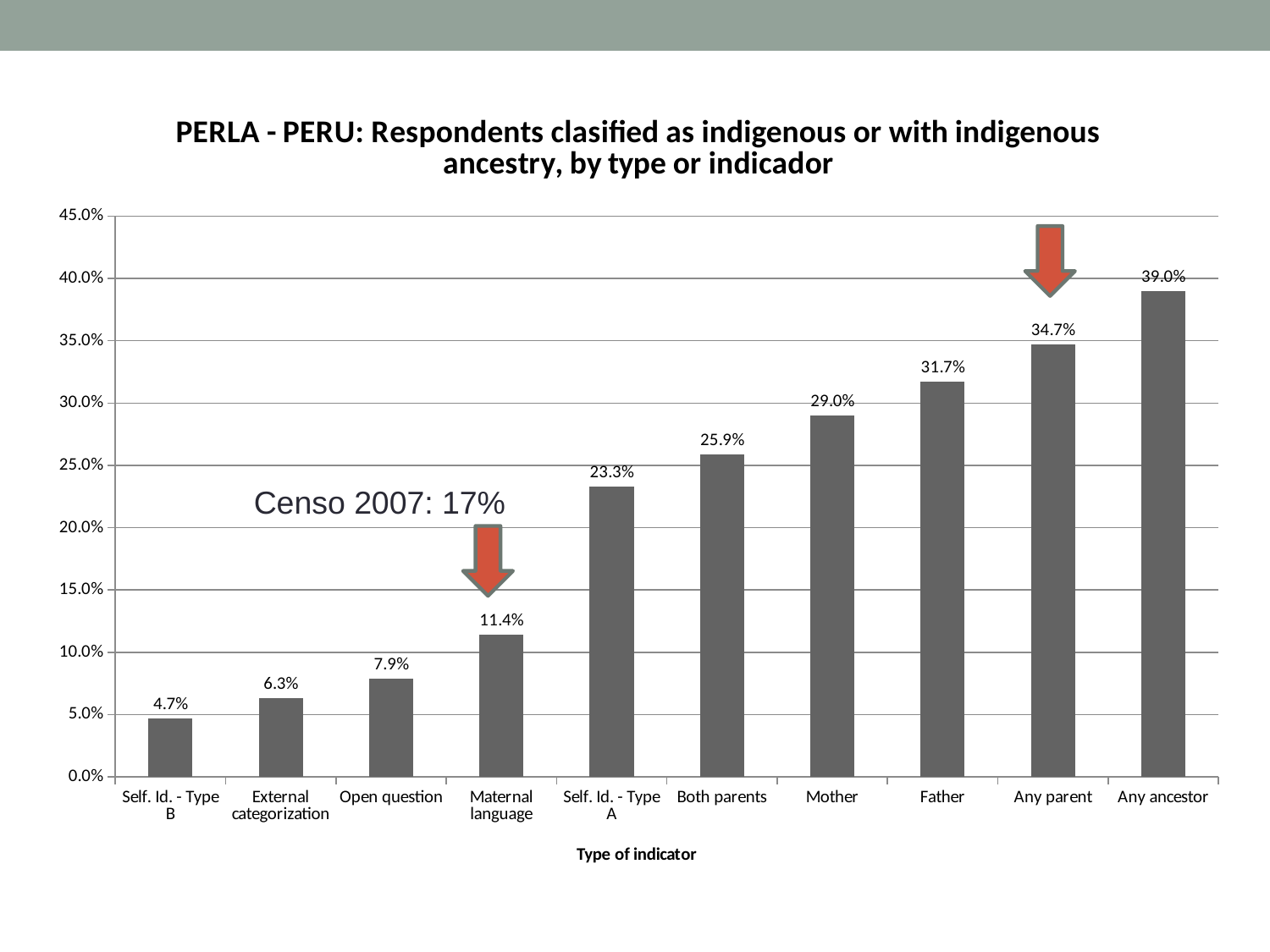
What is the value for Father? 31.7% What is the value for Any parent? 34.7% Which is larger, the value for Open question or the value for External categorization? Open question Which type of indicator has the lowest value? Self. Id. - Type B Do the values rise or fall from left to right along the x axis? Rise What kind of chart is shown on the slide? Bar chart Is the value for Self. Id. - Type A greater or less than 20.0%? greater How many types of indicator are shown on the x axis? 10 What is the difference between the values for Any ancestor and Self. Id. - Type A? 15.7% What is the value for Maternal language? 11.4% Which type of indicator has the highest value? Any ancestor What is the difference between the values for Mother and Both parents? 3.1%